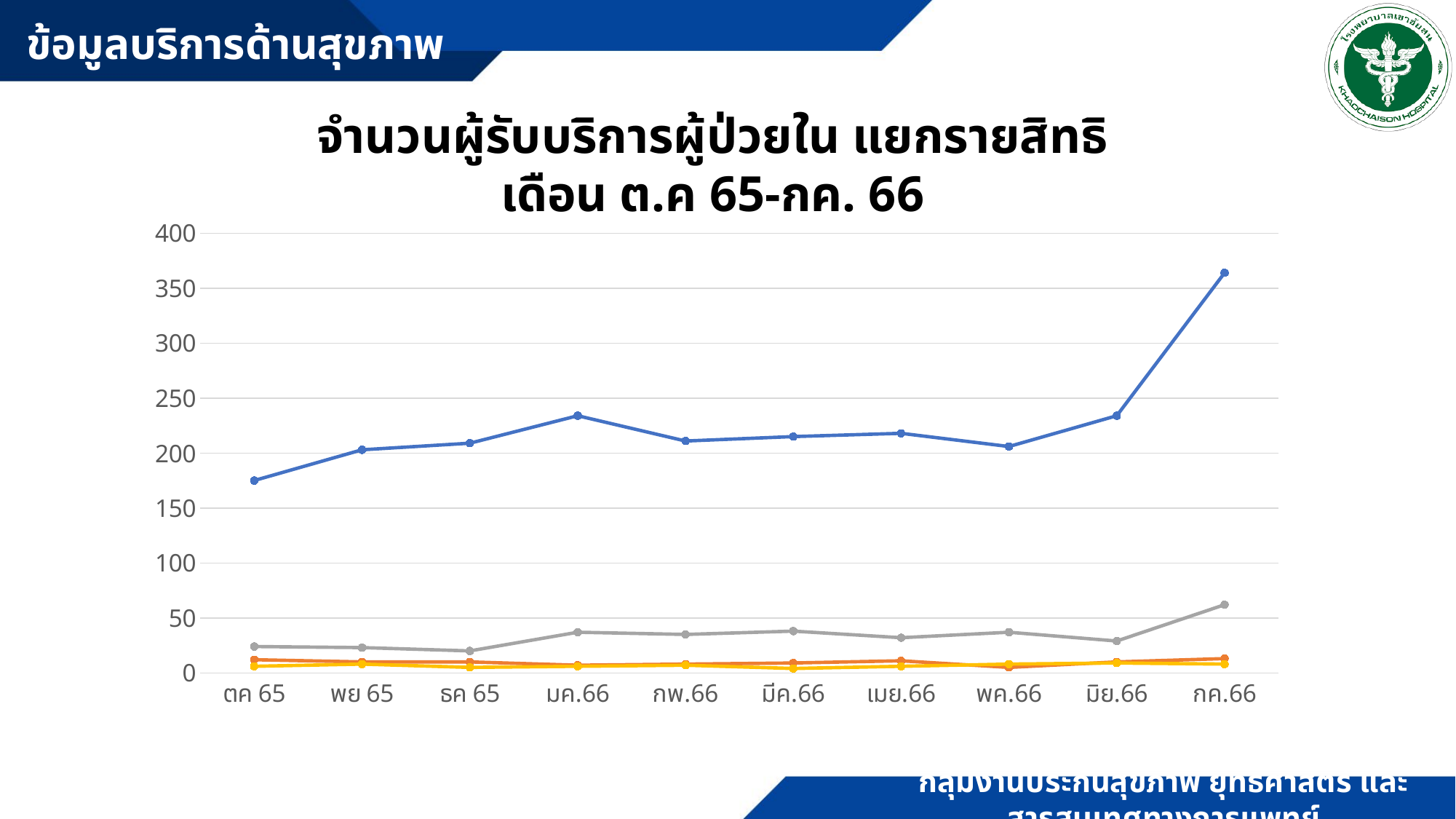
Which line has the larger value for พค.66, the blue line or the gray line? the blue line Is the value of the blue line for กค.66 greater or less than 350? greater Is the value of the gray line for ธค 65 greater or less than 50? less Is the value of the gray line for กค.66 greater or less than 50? greater In which month does the blue line reach its highest value? กค.66 How many months are plotted along the x axis of the chart? 10 What kind of chart is shown on the slide? line chart Does the blue line overall rise or fall from ตค 65 to กค.66? rise In which month does the gray line reach its highest value? กค.66 In which month is the blue line at its lowest value? ตค 65